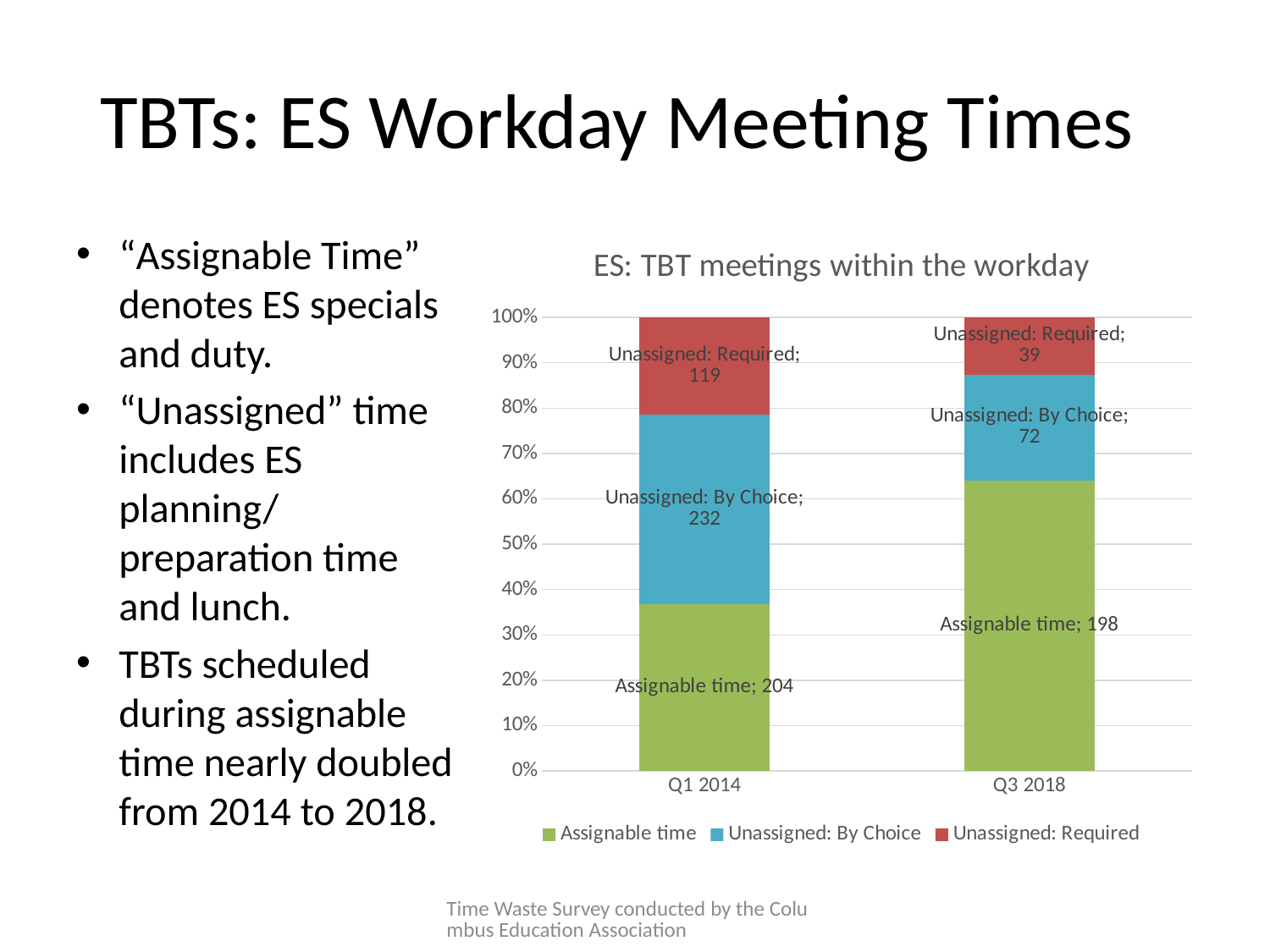
How many series does the legend list? 3 Which is larger, Unassigned: Required in Q1 2014 or Unassigned: Required in Q3 2018? Q1 2014 What is the difference between the Unassigned: By Choice values for Q1 2014 and Q3 2018? 160 Which series has the highest value in Q1 2014? Unassigned: By Choice What is the total of the three values in the Q3 2018 bar? 309 What is the value for Unassigned: By Choice in Q3 2018? 72 What is the value for Unassigned: Required in Q3 2018? 39 What is the value for Assignable time in Q1 2014? 204 What is the value for Unassigned: Required in Q1 2014? 119 What kind of chart is shown on the slide? Stacked bar chart Which series has the lowest value in Q3 2018? Unassigned: Required How many categories are shown on the x axis? 2